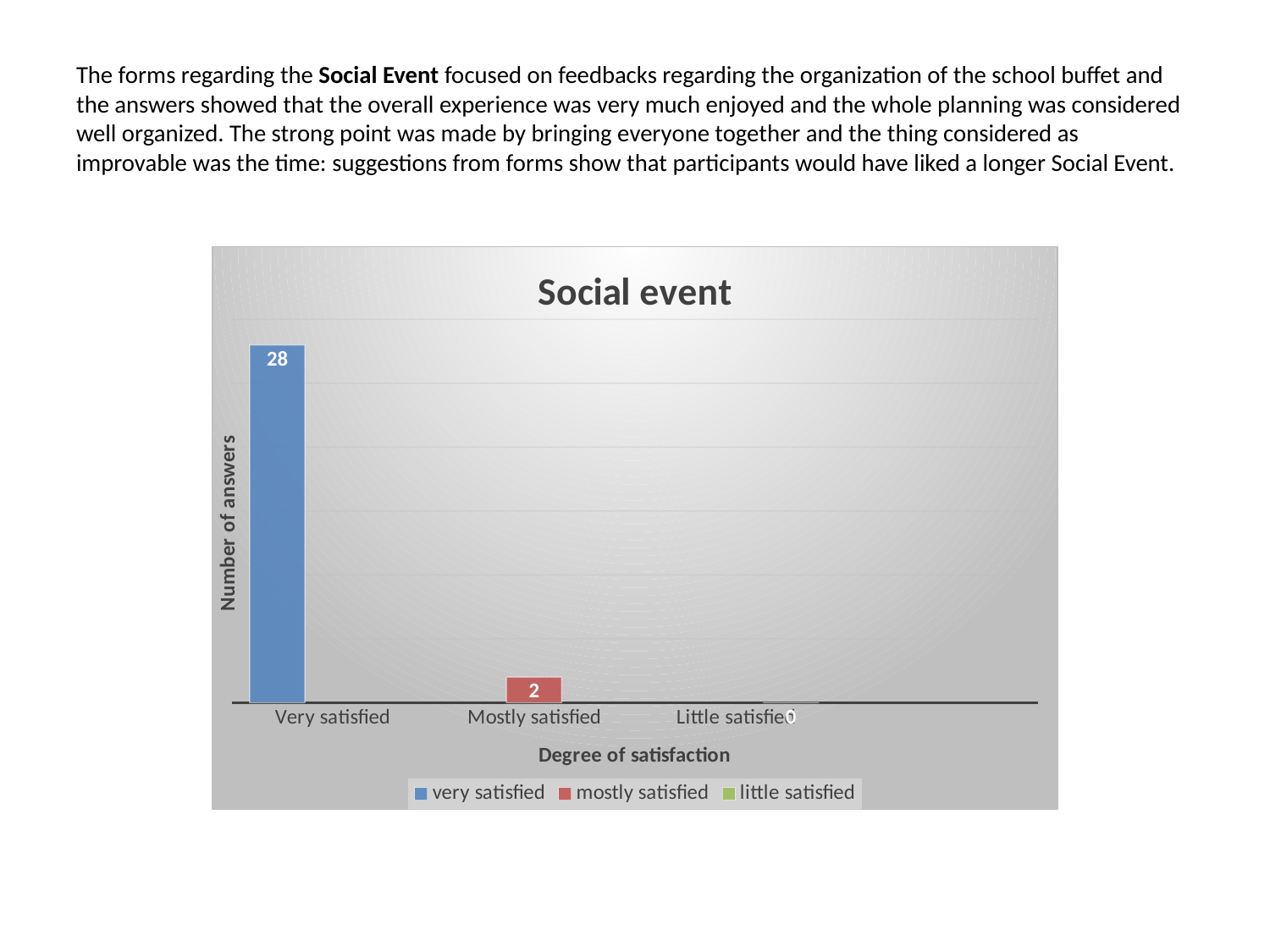
What is the number of answers for Little satisfied? 0 How many categories are shown on the x axis? 3 What is the number of answers for Mostly satisfied? 2 What is the title of the chart? Social event How many entries does the legend list? 3 What kind of chart is shown? Bar chart What is the difference in number of answers between Very satisfied and Mostly satisfied? 26 Which degree of satisfaction has the lowest number of answers? Little satisfied Which has more answers, Mostly satisfied or Little satisfied? Mostly satisfied What is the label of the vertical axis? Number of answers Which degree of satisfaction has the highest number of answers? Very satisfied What is the number of answers for Very satisfied? 28